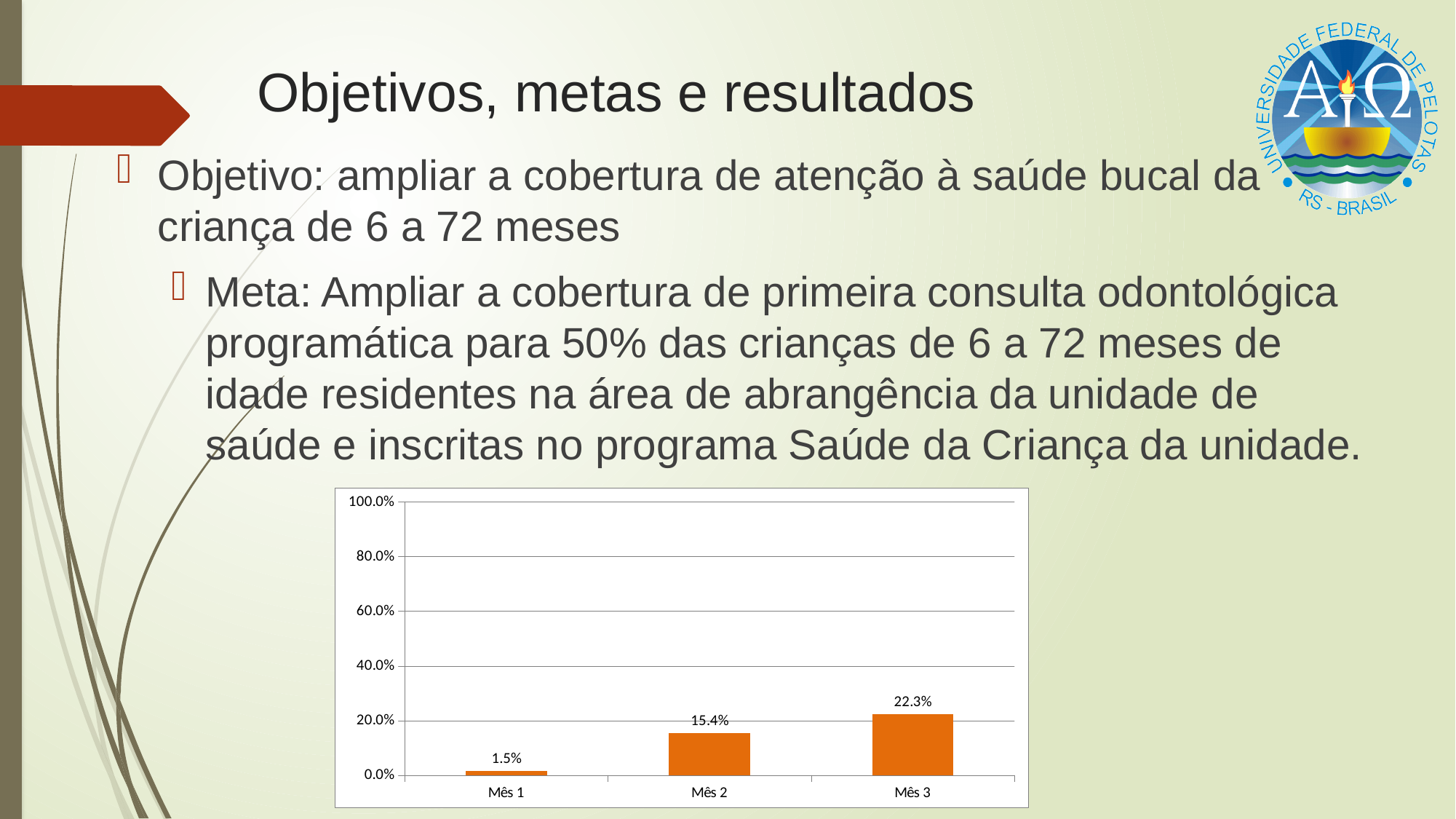
What is the difference between the values for Mês 3 and Mês 2? 6.9% What is the value for Mês 2? 15.4% What kind of chart is shown on the slide? bar chart Which month has the highest value? Mês 3 What is the value for Mês 3? 22.3% Which month has the lowest value? Mês 1 What is the difference between the values for Mês 2 and Mês 1? 13.9% Is the value for Mês 3 greater or less than 20.0%? greater What is the value for Mês 1? 1.5% Do the values rise or fall from Mês 1 to Mês 3? rise How many categories are shown on the x axis? 3 Which is larger, the value for Mês 2 or Mês 3? Mês 3